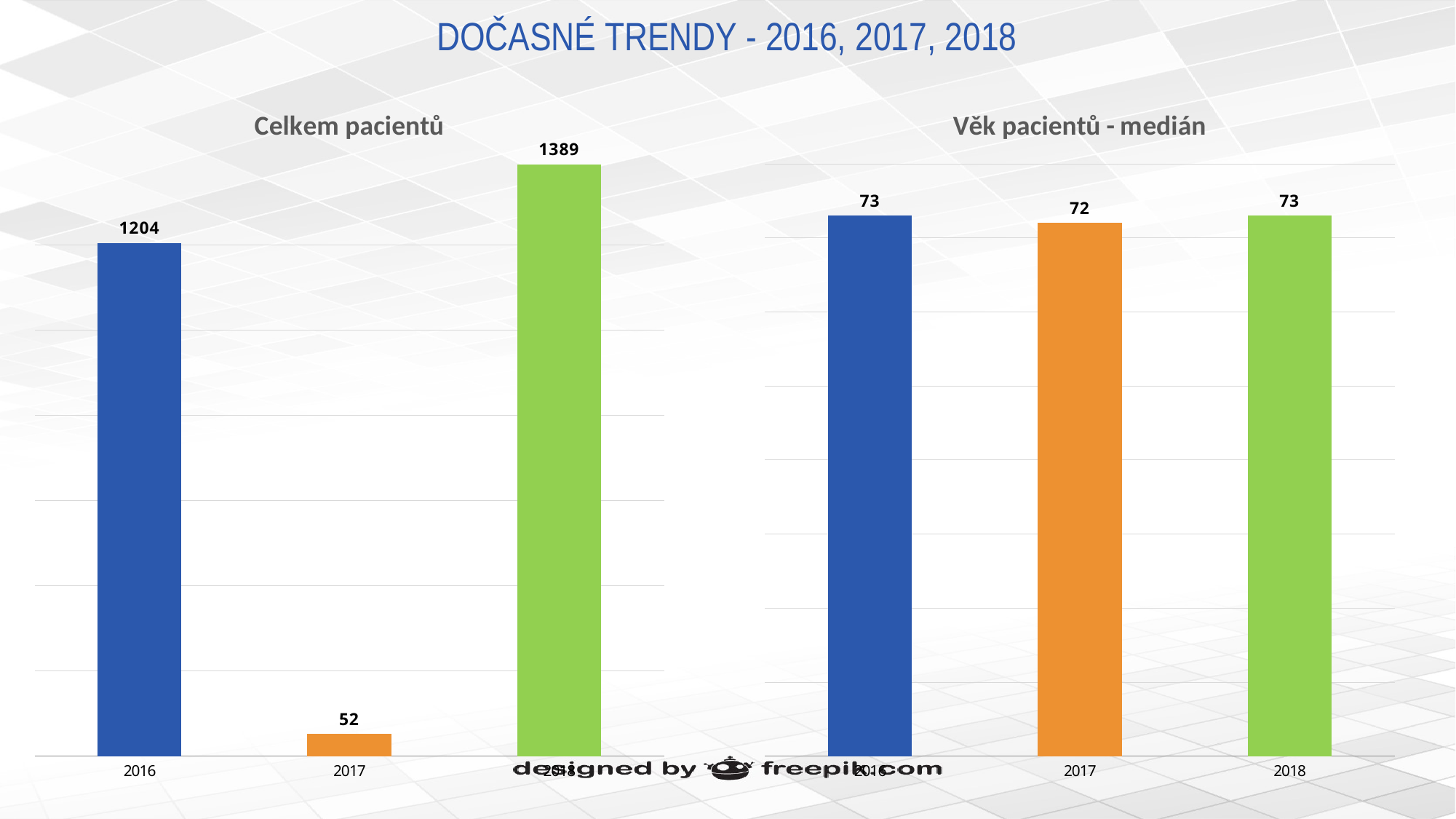
In the 'Celkem pacientů' chart, what is the difference between the values for 2018 and 2016? 185 In the 'Věk pacientů - medián' chart, which year has the lowest value? 2017 How many bars are shown in the 'Celkem pacientů' chart? 3 In the 'Věk pacientů - medián' chart, what is the value for 2017? 72 In the 'Celkem pacientů' chart, which year has the lowest value? 2017 What type of chart is the 'Věk pacientů - medián' chart? Bar chart In the 'Celkem pacientů' chart, which is larger, the value for 2016 or the value for 2017? 2016 In the 'Věk pacientů - medián' chart, what is the difference between the values for 2016 and 2017? 1 In the 'Celkem pacientů' chart, what is the value for 2016? 1204 In the 'Věk pacientů - medián' chart, what is the value for 2018? 73 In the 'Celkem pacientů' chart, what is the value for 2017? 52 In the 'Celkem pacientů' chart, which year has the highest value? 2018